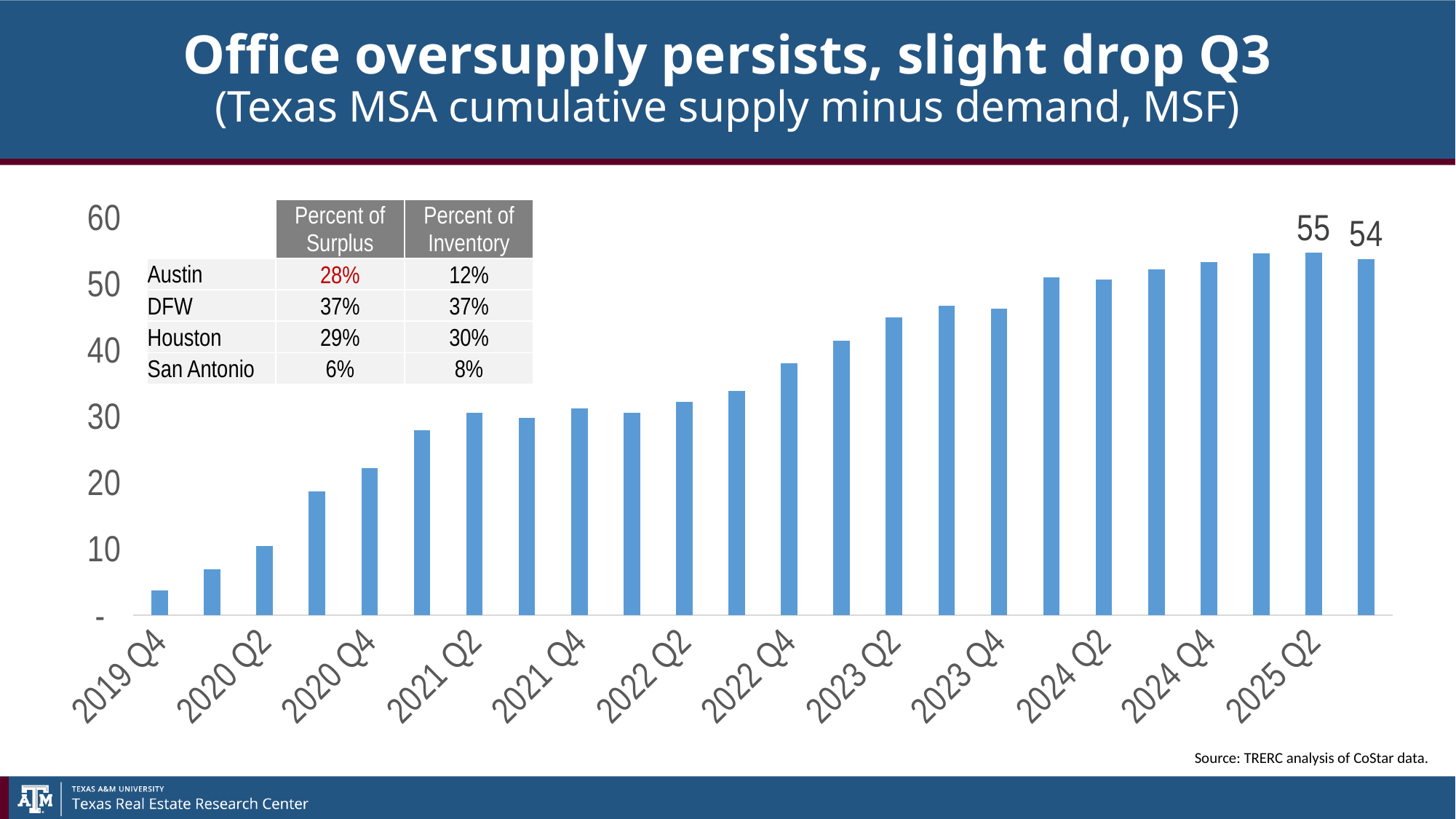
What is the difference between the 2025 Q2 bar and the final bar? 1 Is the value for 2022 Q4 greater or less than 30? greater How many bars are plotted on the chart? 24 Which quarter has the highest value on the chart? 2025 Q2 Do the values generally rise or fall from 2019 Q4 to 2025 Q2? rise What is the value for 2025 Q2? 55 Which quarter has the lowest value on the chart? 2019 Q4 Which is larger, the value for 2020 Q2 or the value for 2021 Q2? 2021 Q2 What kind of chart is shown on the slide? bar chart Is the value for 2019 Q4 greater or less than 10? less Is the value for 2023 Q4 greater or less than 50? less What is the value of the final (rightmost) bar on the chart? 54